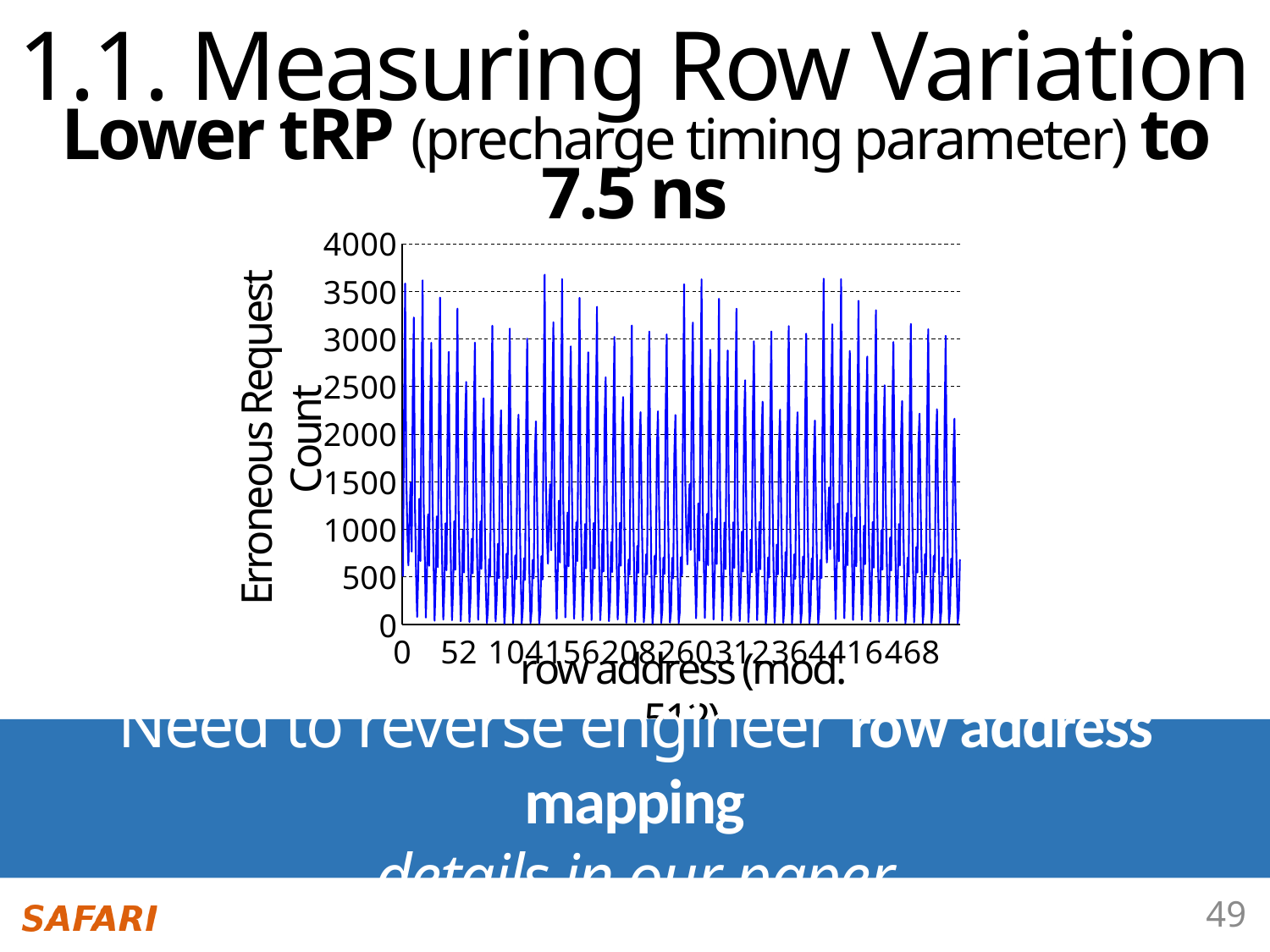
What is the lowest value shown on the y-axis of the chart? 0 Is the highest peak of the erroneous request count greater or less than 4000? less What is the interval between consecutive tick marks on the y-axis? 500 How many tick labels are shown on the x-axis of the chart? 10 Is the highest peak of the erroneous request count greater or less than 3500? greater What colour is the plotted line in the chart? blue How many data series are plotted in the chart? 1 What is the last tick label on the x-axis of the chart? 468 What is the label of the y-axis of the chart? Erroneous Request Count What kind of chart is shown on the slide? line chart What is the highest value shown on the y-axis of the chart? 4000